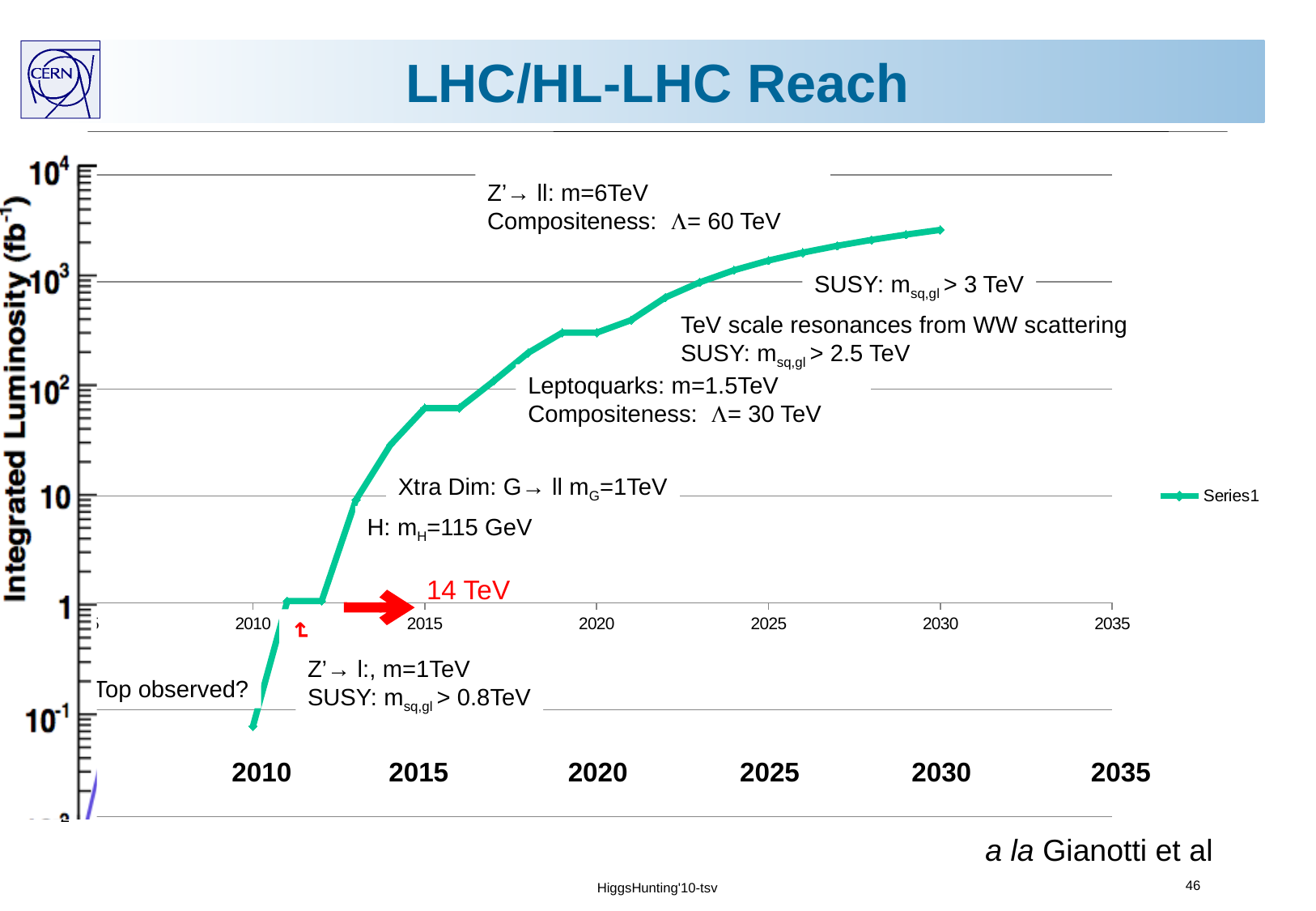
Is the value for 2015 greater or less than 100? less Which is larger, the value for 2025 or the value for 2020? 2025 How many series does the legend list? 1 Is the value for 2020 greater or less than 100? greater Do the plotted values rise or fall as the year increases along the x axis? rise Is the value for 2030 greater or less than 1000? greater What is the name of the series shown in the legend? Series1 Which year has the highest plotted value? 2030 What is the label of the vertical axis? Integrated Luminosity (fb-1) What kind of chart is shown on the slide? line chart